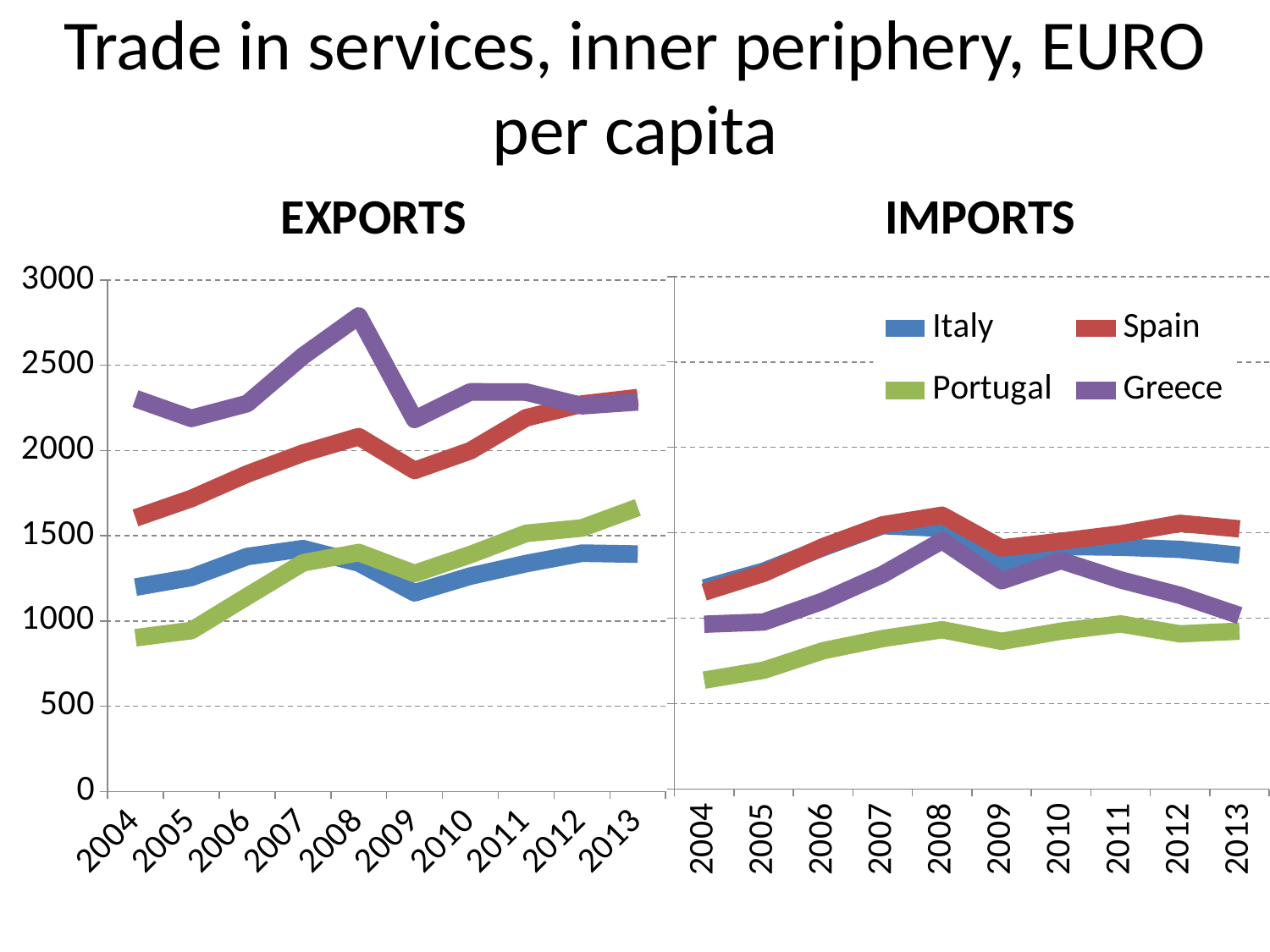
What kind of chart is the EXPORTS chart? line chart In the IMPORTS chart, which country has the lowest value in 2013? Portugal How many series does the legend list? 4 In the EXPORTS chart, which country has the lowest value in 2004? Portugal How many years are plotted on the x axis of the IMPORTS chart? 10 In the IMPORTS chart, does the Greece line rise or fall from 2008 to 2013? fall In the EXPORTS chart, which country has the highest value in 2008? Greece In the EXPORTS chart, is the value for Portugal in 2004 greater or less than 1000? less In the EXPORTS chart, which is larger in 2013, Portugal or Italy? Portugal In the IMPORTS chart, is the value for Spain in 2008 greater or less than 1500? greater Which colour represents Spain in the legend? red In the EXPORTS chart, is the value for Greece in 2008 greater or less than 2500? greater